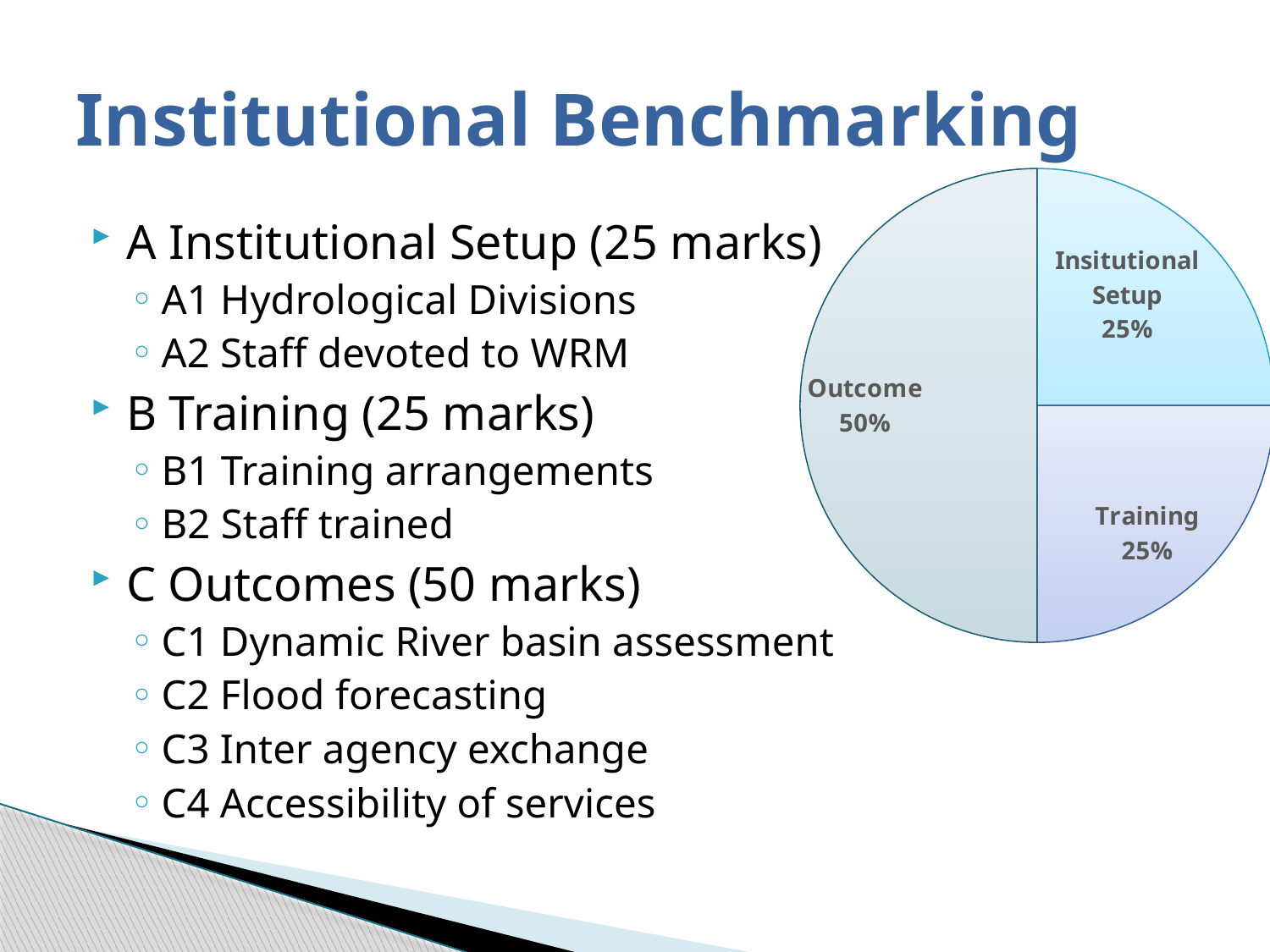
Which slice of the pie chart is the largest? Outcome What share of the pie does the Training slice represent? 25% Which is larger, the Outcome slice or the Insitutional Setup slice? Outcome What share of the pie does the Outcome slice represent? 50% What kind of chart is shown on the slide? pie chart Is the share for Outcome greater or less than 40%? greater What share of the pie does the Insitutional Setup slice represent? 25% Which slice of the pie chart is labelled on the left half? Outcome How many slices does the pie chart have? 3 What is the difference between the Outcome share and the Training share? 25% What is the combined share of the Insitutional Setup and Training slices? 50%